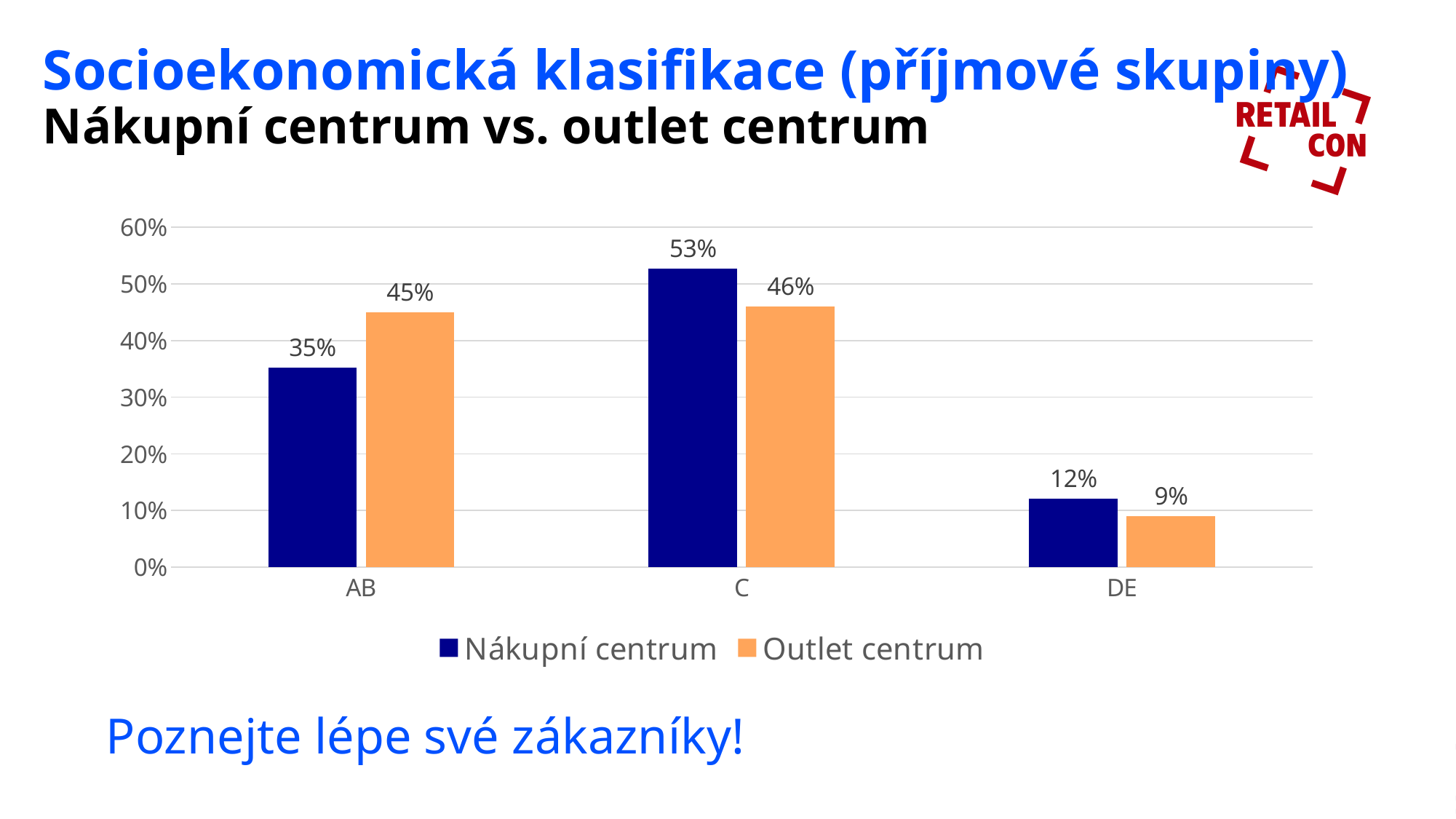
What is the value for Outlet centrum in category DE? 9% What is the value for Nákupní centrum in category AB? 35% Which category has the highest value for Nákupní centrum? C In category DE, which series has the larger value, Nákupní centrum or Outlet centrum? Nákupní centrum How many categories are shown on the x axis? 3 What colour are the bars for Outlet centrum? Orange Which category has the lowest value for Outlet centrum? DE What is the value for Outlet centrum in category C? 46% What kind of chart is shown on the slide? Bar chart What is the difference between Nákupní centrum and Outlet centrum in category C? 7% What is the difference between Outlet centrum and Nákupní centrum in category AB? 10% How many series does the legend list? 2